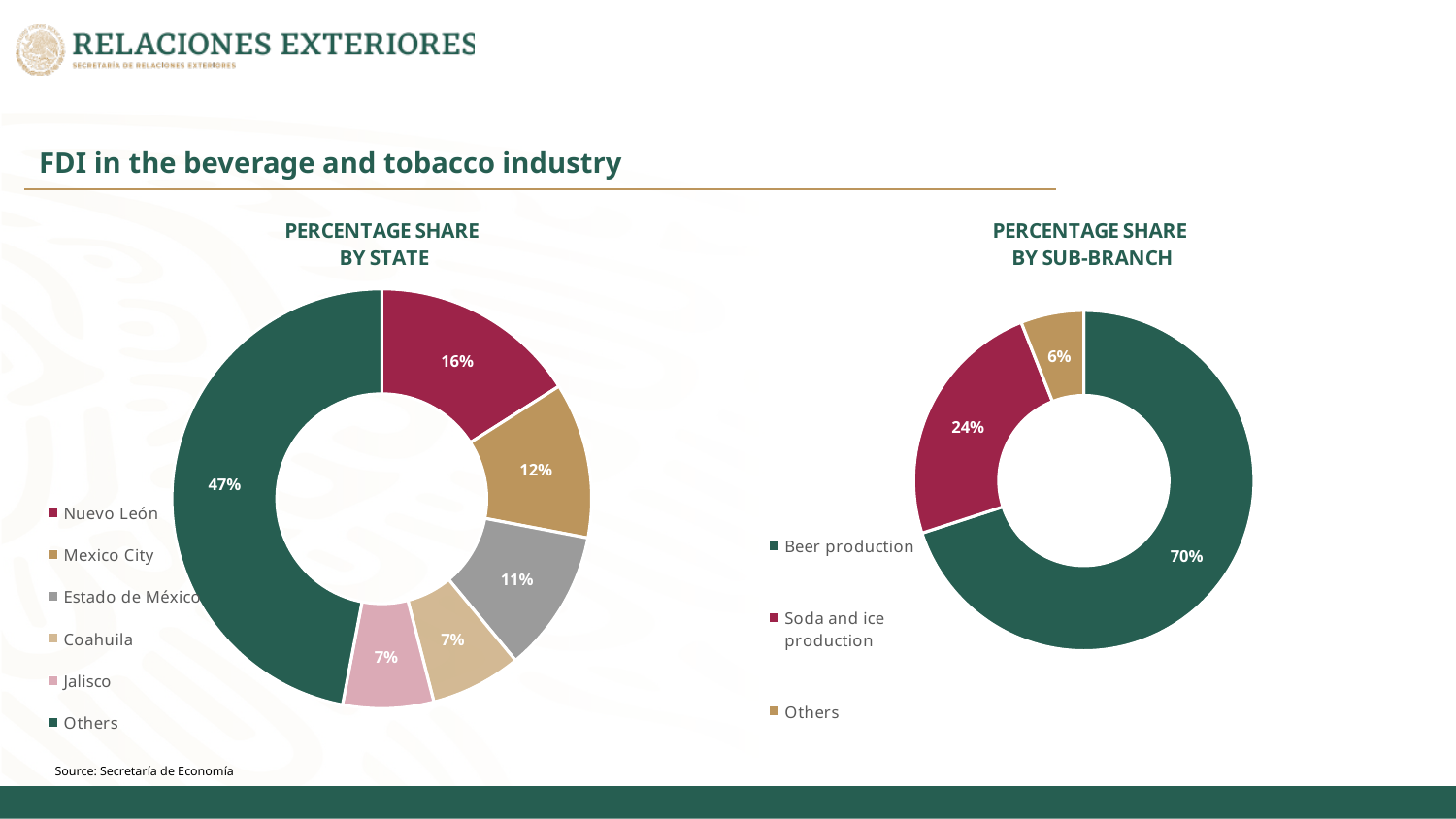
In the 'Percentage share by sub-branch' chart, what share does Beer production have? 70% In the 'Percentage share by state' chart, what share does Nuevo León have? 16% In the 'Percentage share by sub-branch' chart, which category has the smallest share? Others In the 'Percentage share by sub-branch' chart, what is the difference between the shares of Beer production and Soda and ice production? 46% In the 'Percentage share by state' chart, what share does Estado de México have? 11% In the 'Percentage share by state' chart, what share does Mexico City have? 12% In the 'Percentage share by state' chart, which category has the largest share? Others What kind of chart is the 'Percentage share by sub-branch' chart? Donut (pie) chart In the 'Percentage share by state' chart, what is the difference between the shares of Nuevo León and Mexico City? 4% In the 'Percentage share by state' chart, which is larger: the share of Estado de México or the share of Coahuila? Estado de México In the 'Percentage share by sub-branch' chart, what share does Soda and ice production have? 24% In the 'Percentage share by state' chart, how many categories does the legend list? 6